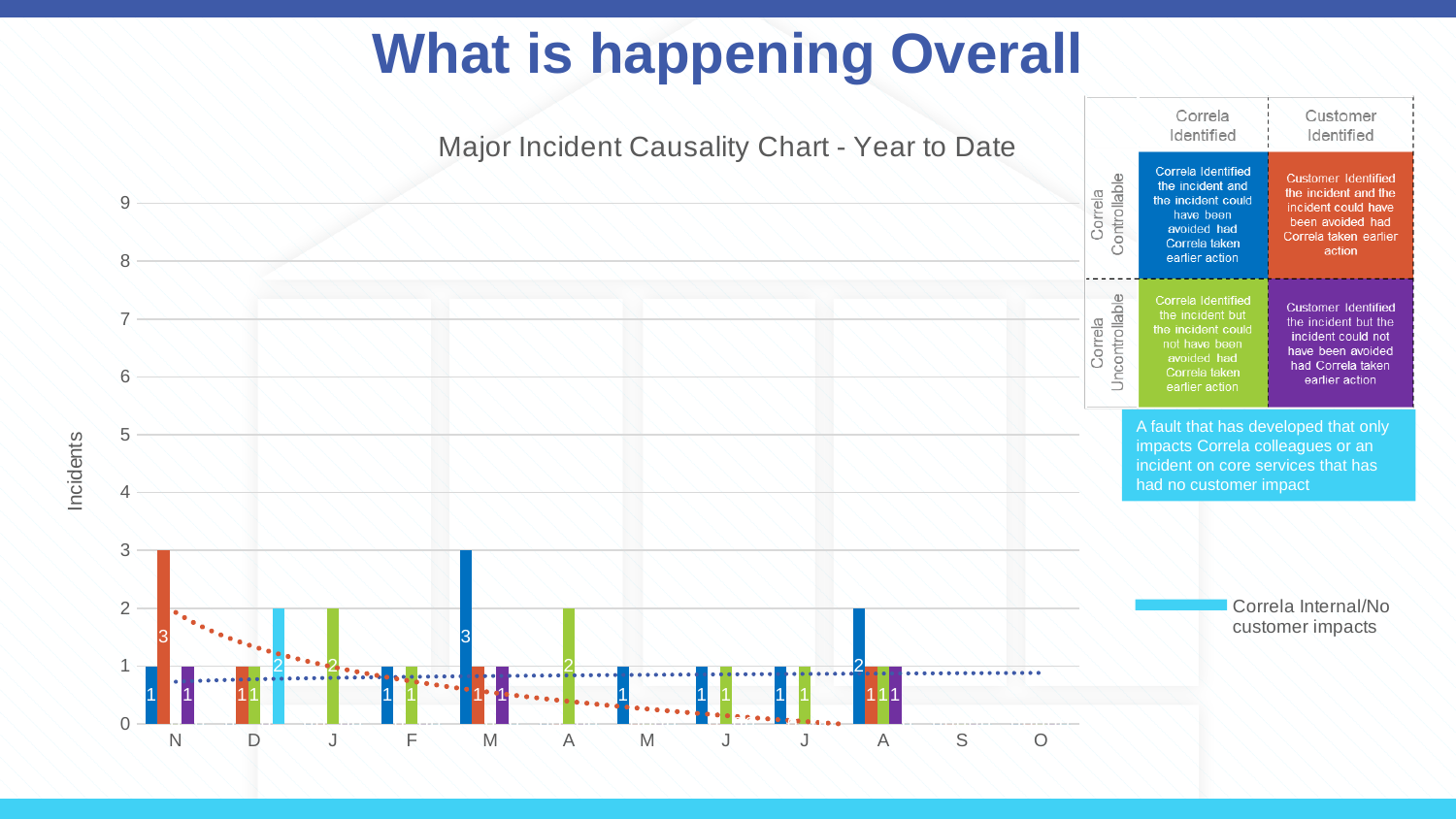
How many month categories are shown along the x axis? 12 Is the tallest bar on the chart greater or less than 5? less What is the title of the chart? Major Incident Causality Chart - Year to Date What kind of chart is the Major Incident Causality Chart? bar chart Which is larger: the dark blue bar for the first month labelled M or the dark blue bar for the second month labelled A? the first M What is the value of the orange bar for the month labelled N? 3 What is the value of the green bar for the first month labelled J? 2 What is the difference between the orange bar and the dark blue bar for the month labelled N? 2 What is the highest value reached by any bar on the chart? 3 What is the value of the dark blue bar for the first month labelled M? 3 What is the value of the light blue bar for the month labelled D? 2 What is the label on the vertical axis of the chart? Incidents